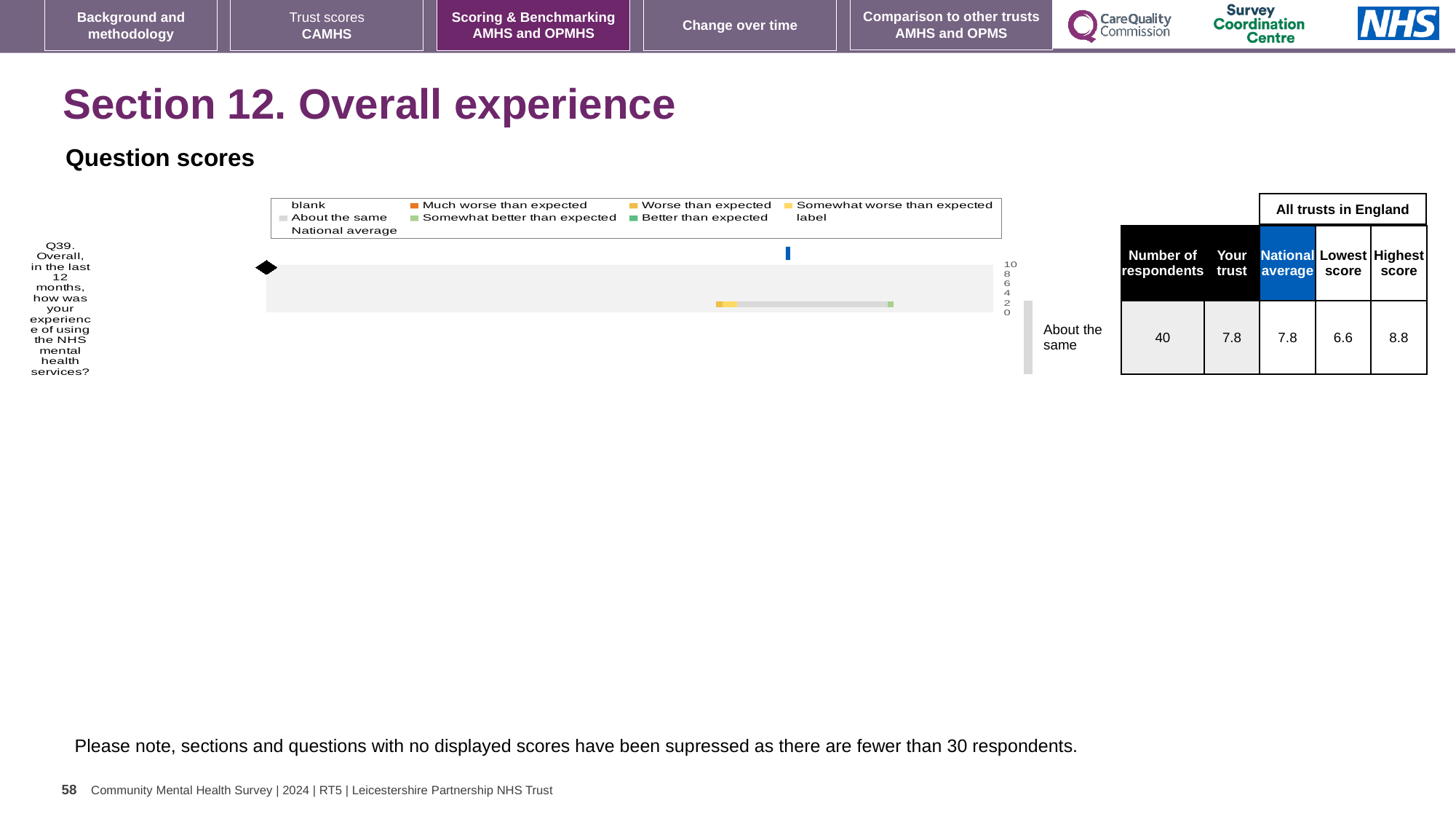
According to the table beside the chart, what is the 'Your trust' score for Q39? 7.8 What benchmark category label is shown next to the chart for Q39? About the same According to the table beside the chart, what is the highest score among all trusts in England for Q39? 8.8 According to the table beside the chart, how many respondents answered Q39? 40 How many question categories are plotted on the chart? 1 What kind of chart is shown on the slide? bar chart What is the highest tick value shown on the chart's axis? 10 Which question is plotted on the chart? Q39. Overall, in the last 12 months, how was your experience of using the NHS mental health services? According to the table beside the chart, what is the lowest score among all trusts in England for Q39? 6.6 What is the difference between the highest score and the lowest score for Q39 shown in the table beside the chart? 2.2 According to the table beside the chart, what is the national average score for Q39? 7.8 Is the 'Your trust' score for Q39 larger than, smaller than, or equal to the national average? equal